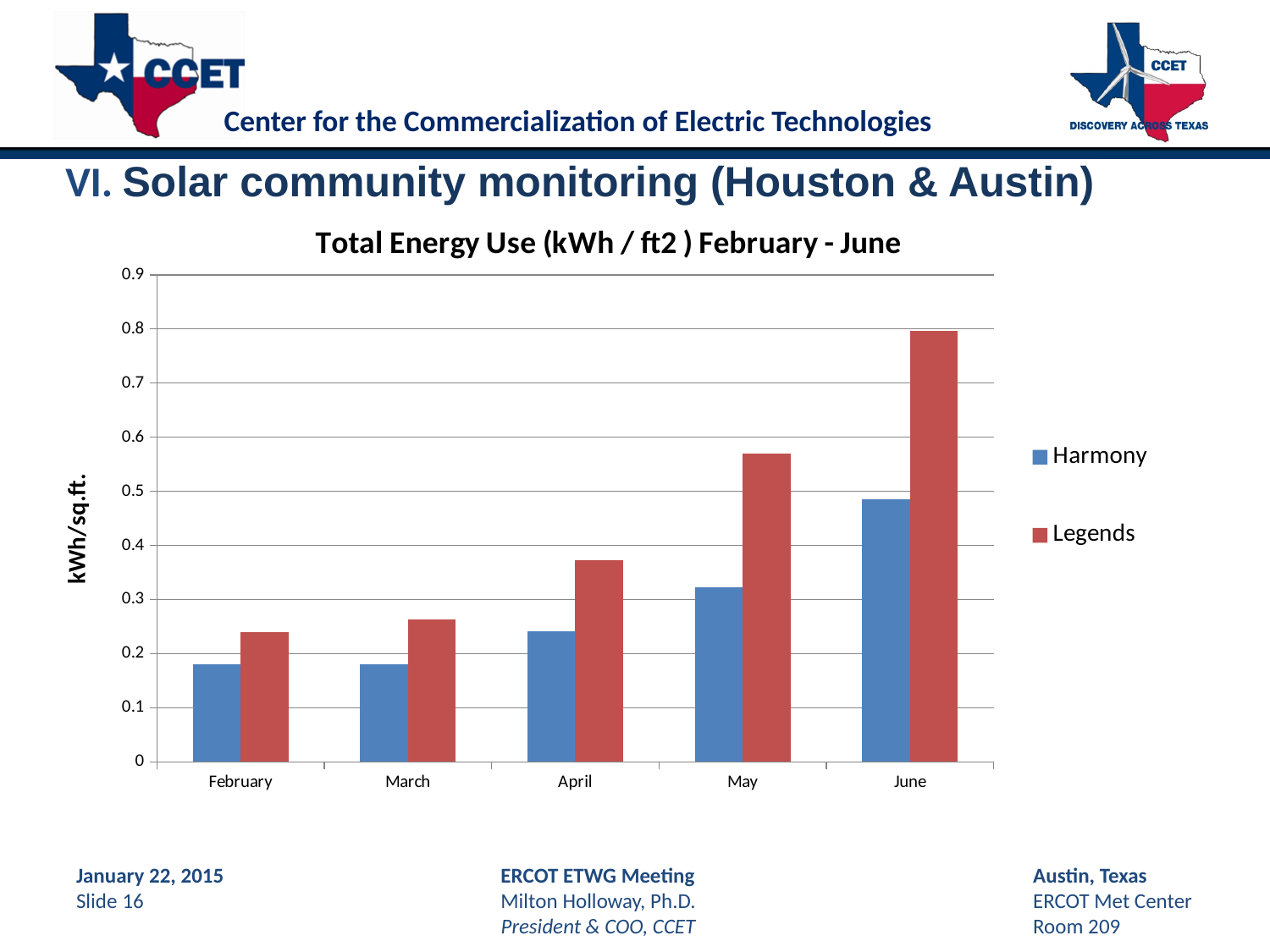
Do the Legends values rise or fall from February to June? rise In June, which series has the larger value, Harmony or Legends? Legends Is the value for Legends in June greater or less than 0.7? greater Is the value for Legends in April greater or less than 0.4? less How many series does the legend list? 2 Which month has the highest value for Legends? June How many months are shown on the x axis? 5 What is the title of the chart? Total Energy Use (kWh / ft2 ) February - June Is the value for Legends in May greater or less than 0.5? greater Which month has the highest value for Harmony? June What type of chart is shown on the slide? bar chart